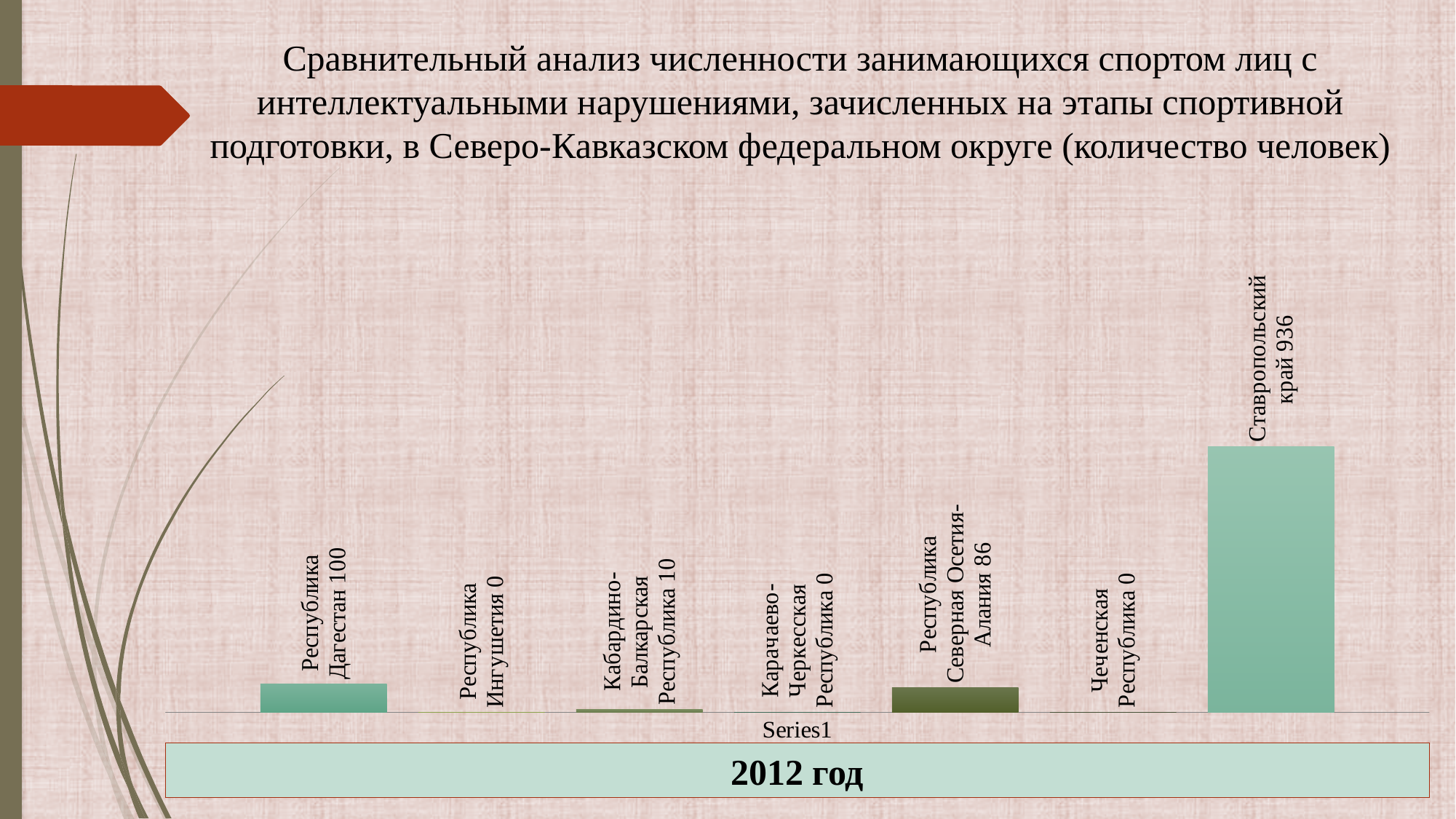
Which is larger, the value for Республика Дагестан or the value for Кабардино-Балкарская Республика? Республика Дагестан What is the value for Республика Дагестан? 100 What is the value for Кабардино-Балкарская Республика? 10 What is the value for Ставропольский край? 936 Which region has the highest value? Ставропольский край What is the difference between the values for Ставропольский край and Республика Дагестан? 836 How many regions are shown in the chart? 7 What is the value for Республика Северная Осетия-Алания? 86 Which year is shown in the label below the chart? 2012 год What kind of chart is shown on the slide? Bar chart What is the value for Чеченская Республика? 0 What is the difference between the values for Республика Дагестан and Республика Северная Осетия-Алания? 14